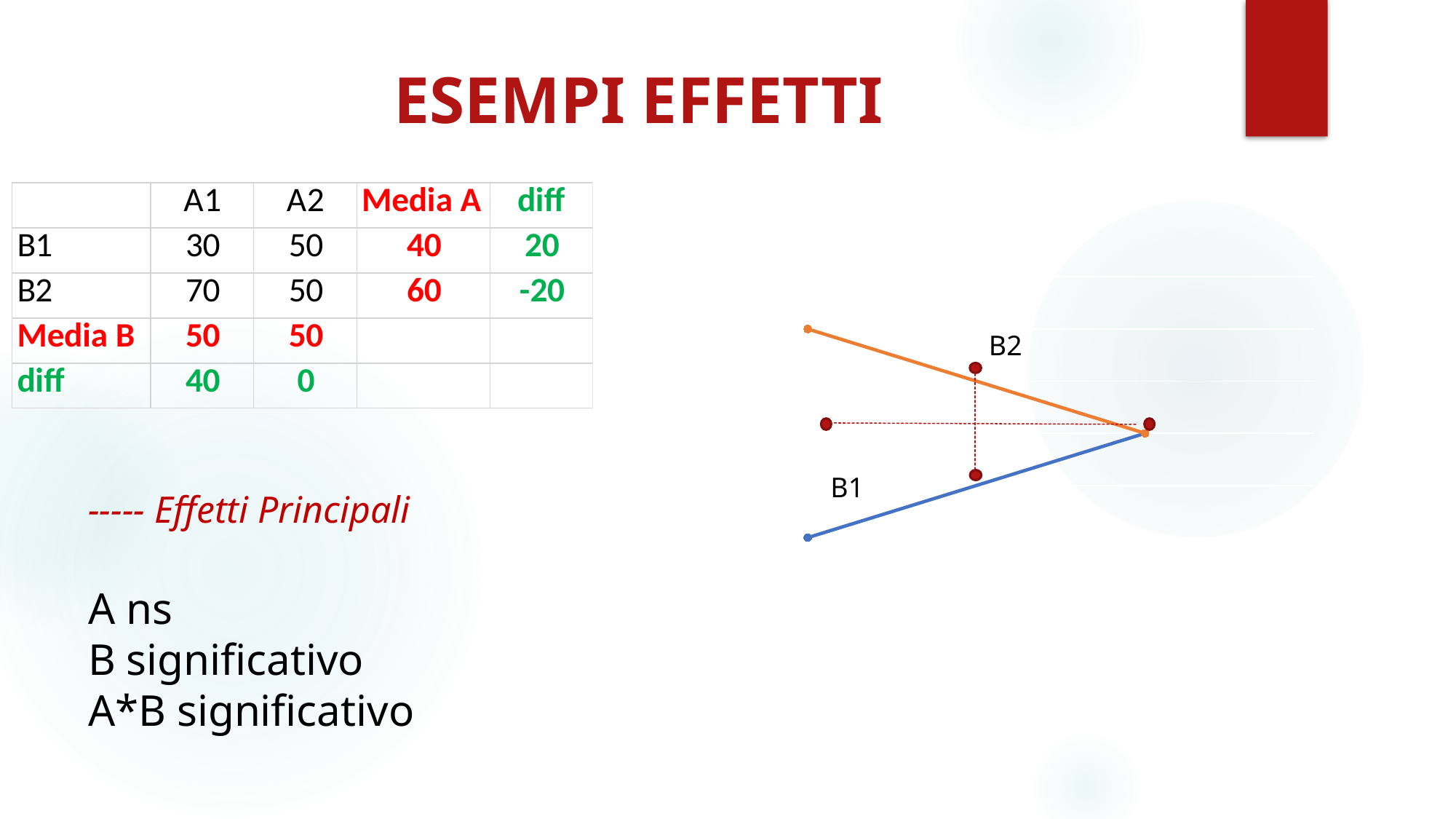
Does the B2 line rise or fall from left to right in the chart? fall What do the dashed red lines in the chart represent, according to the slide's legend text? Effetti Principali Which line in the chart is labelled B2, the orange one or the blue one? orange Which line in the chart is labelled B1, the orange one or the blue one? blue How many lines are plotted in the chart on the right? 2 What kind of chart is shown on the right of the slide? line chart Does the B1 line rise or fall from left to right in the chart? rise Do the B1 and B2 lines meet at the left end or the right end of the chart? right end At the left end of the chart, which line is higher, B1 or B2? B2